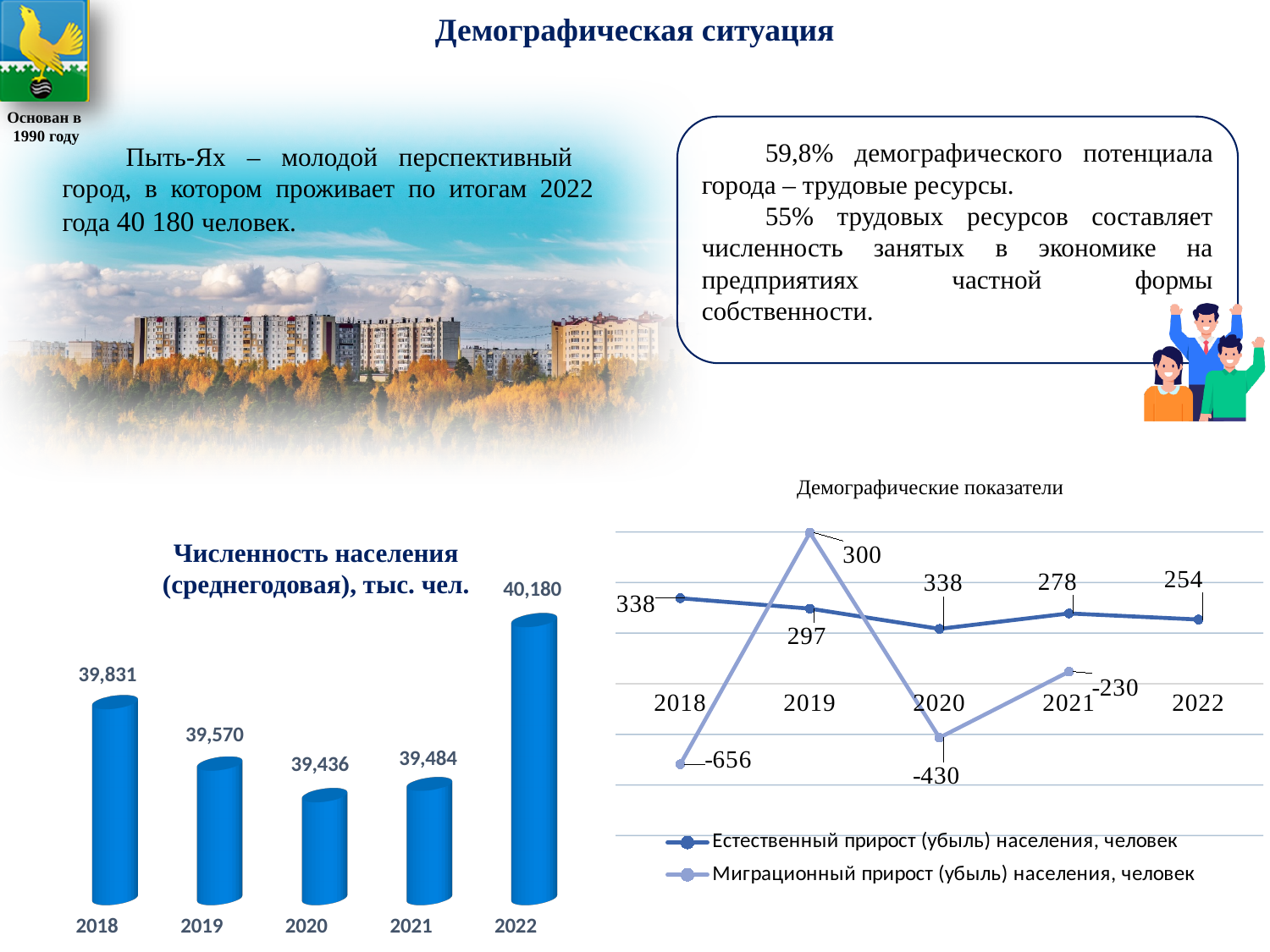
In the 'Численность населения (среднегодовая), тыс. чел.' chart, what is the difference between the 2022 and 2018 values? 349 In the 'Численность населения (среднегодовая), тыс. чел.' chart, what is the value for 2022? 40,180 How many series does the legend of the 'Демографические показатели' chart list? 2 In the 'Численность населения (среднегодовая), тыс. чел.' chart, how many years are shown? 5 In the 'Численность населения (среднегодовая), тыс. чел.' chart, which year has the highest value? 2022 In the 'Демографические показатели' chart, what is the value of 'Миграционный прирост (убыль) населения, человек' for 2018? -656 In the 'Демографические показатели' chart, which is larger in 2020: 'Естественный прирост (убыль) населения, человек' or 'Миграционный прирост (убыль) населения, человек'? Естественный прирост (убыль) населения, человек What kind of chart is 'Численность населения (среднегодовая), тыс. чел.'? Bar chart In the 'Численность населения (среднегодовая), тыс. чел.' chart, which year has the lowest value? 2020 In the 'Численность населения (среднегодовая), тыс. чел.' chart, what is the value for 2020? 39,436 In the 'Демографические показатели' chart, what is the value of 'Естественный прирост (убыль) населения, человек' for 2019? 297 What kind of chart is 'Демографические показатели'? Line chart